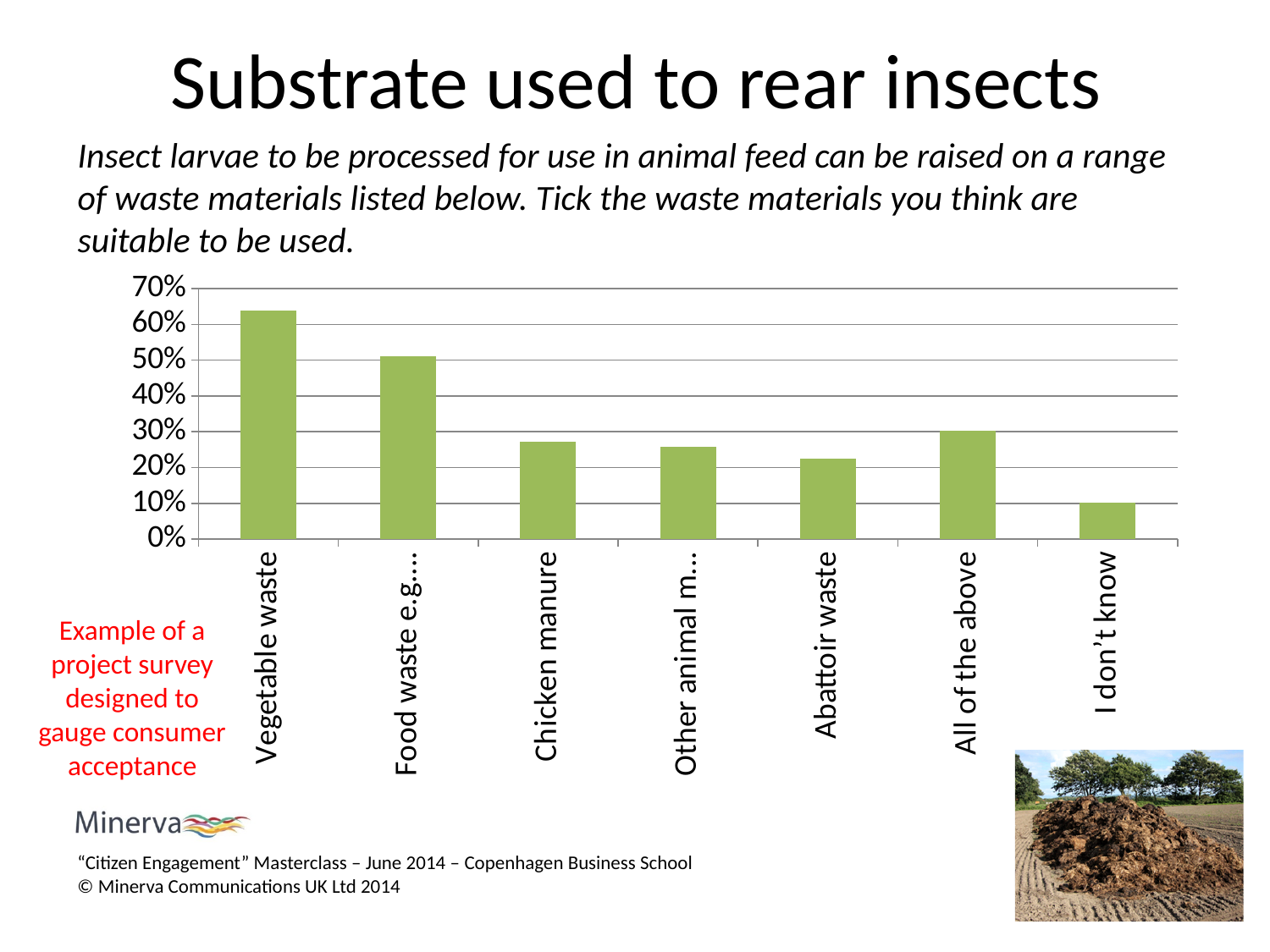
How many categories are shown on the x axis of the chart? 7 What colour are the bars in the chart? green Is the value for Food waste greater or less than 40%? greater Which category has the highest value in the chart? Vegetable waste Is the value for I don't know greater or less than 20%? less Is the value for Vegetable waste greater or less than 60%? greater Which is larger, the value for Vegetable waste or the value for Food waste? Vegetable waste What kind of chart is shown on the slide? bar chart Which is larger, the value for Abattoir waste or the value for All of the above? All of the above Which category has the lowest value in the chart? I don't know